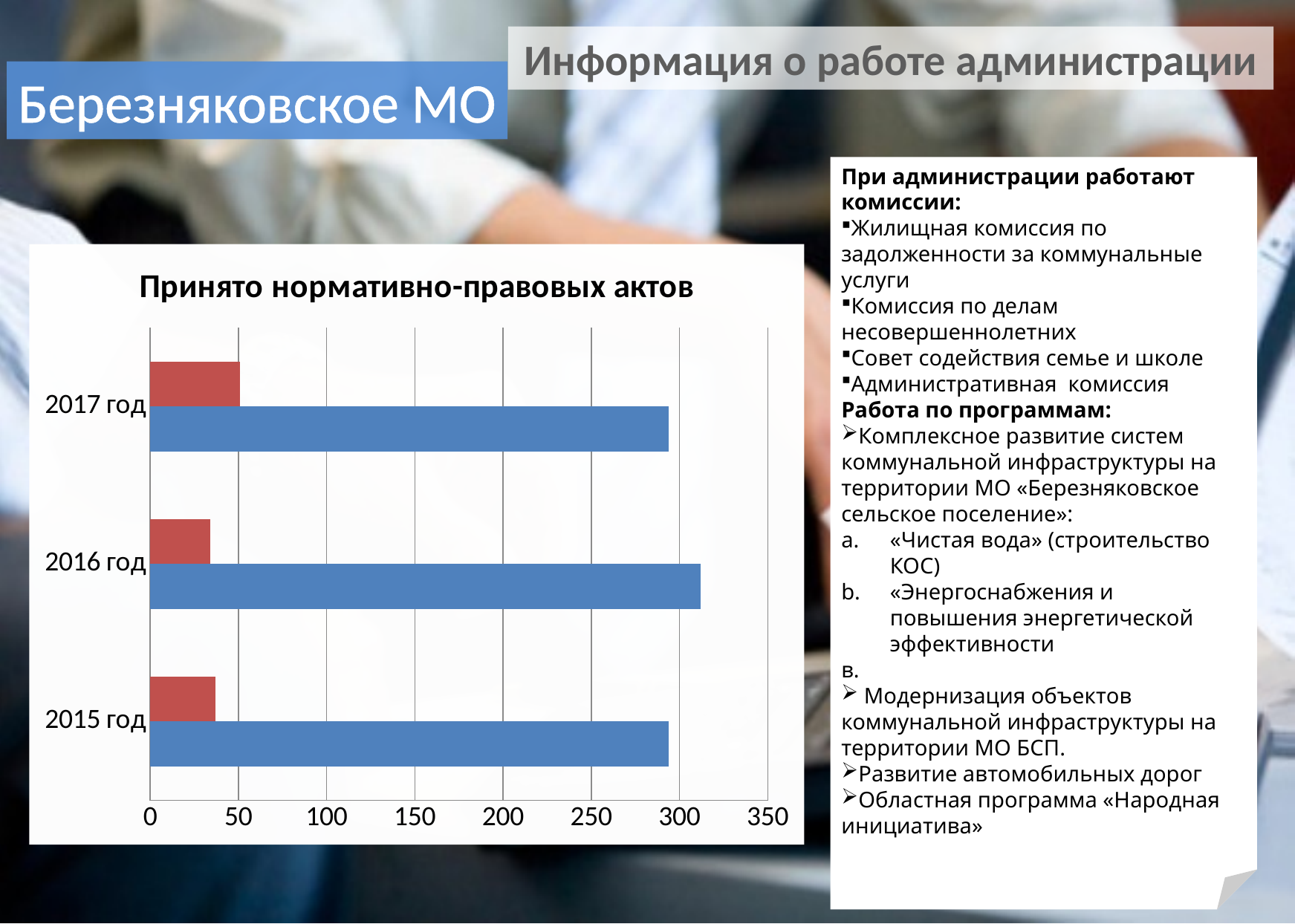
Is the red bar for 2016 год greater or less than 50? less What kind of chart is shown on the slide? bar chart Is the red bar for 2015 год greater or less than 50? less How many data series are plotted in the chart? 2 Which year has the longest blue bar? 2016 год Which year has the longest red bar? 2017 год How many year categories are shown on the chart? 3 Which is larger: the blue bar for 2016 год or the blue bar for 2017 год? 2016 год What is the title of the chart? Принято нормативно-правовых актов Is the blue bar for 2017 год greater or less than 300? less Which is larger: the red bar for 2017 год or the red bar for 2016 год? 2017 год